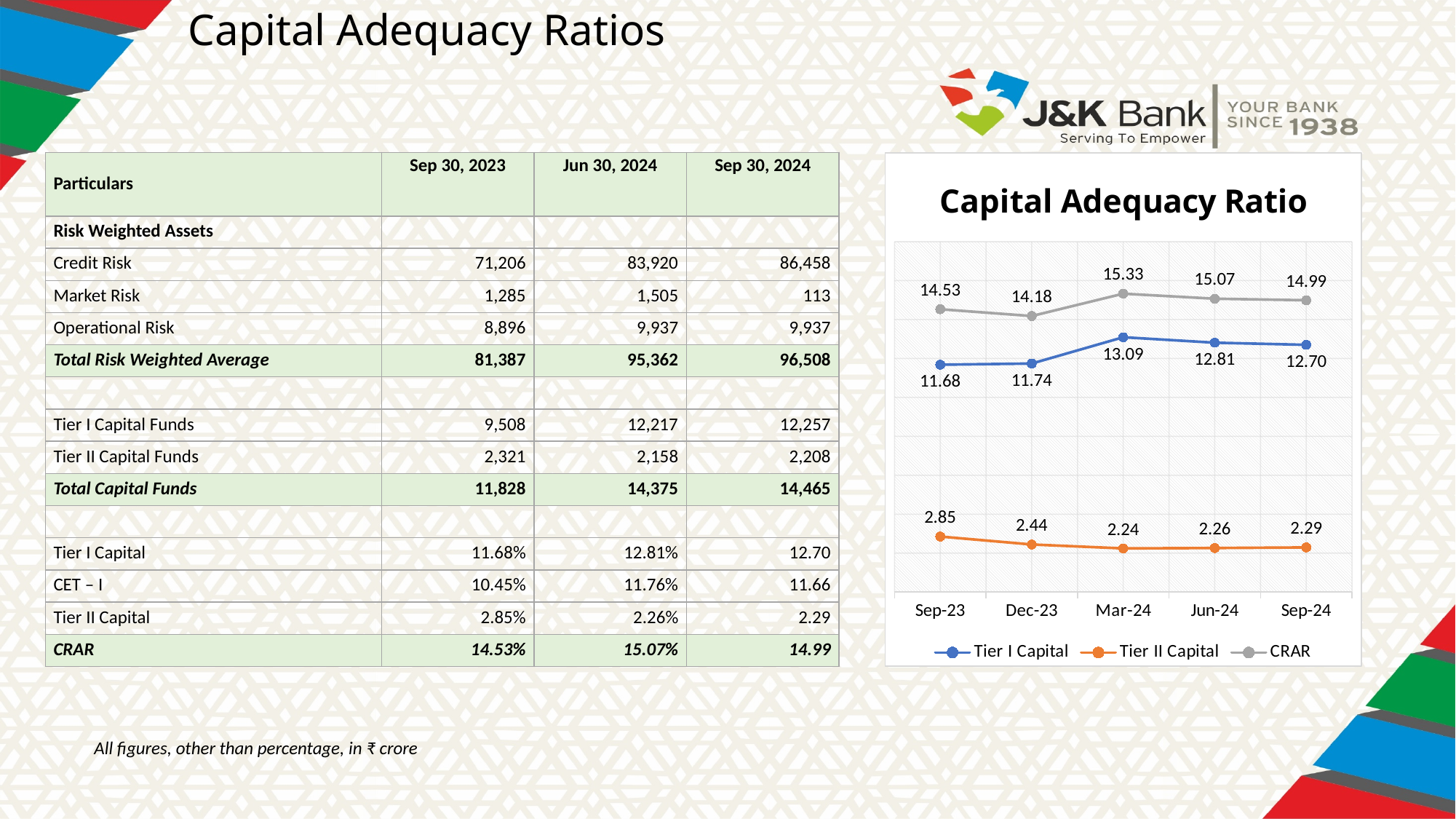
What type of chart is the Capital Adequacy Ratio chart? line chart Which series is shown in orange in the Capital Adequacy Ratio chart? Tier II Capital At which time point is CRAR highest in the Capital Adequacy Ratio chart? Mar-24 What is the Tier II Capital value for Jun-24 in the Capital Adequacy Ratio chart? 2.26 Does Tier II Capital rise or fall from Sep-23 to Mar-24 in the Capital Adequacy Ratio chart? fall Which is larger in the Capital Adequacy Ratio chart: Tier I Capital at Dec-23 or Tier I Capital at Mar-24? Tier I Capital at Mar-24 How many series does the legend of the Capital Adequacy Ratio chart list? 3 What is the CRAR value for Mar-24 in the Capital Adequacy Ratio chart? 15.33 What is the Tier I Capital value for Sep-23 in the Capital Adequacy Ratio chart? 11.68 At which time point is Tier II Capital lowest in the Capital Adequacy Ratio chart? Mar-24 What is the difference between the CRAR values for Mar-24 and Sep-24 in the Capital Adequacy Ratio chart? 0.34 How many time points are plotted on the x axis of the Capital Adequacy Ratio chart? 5